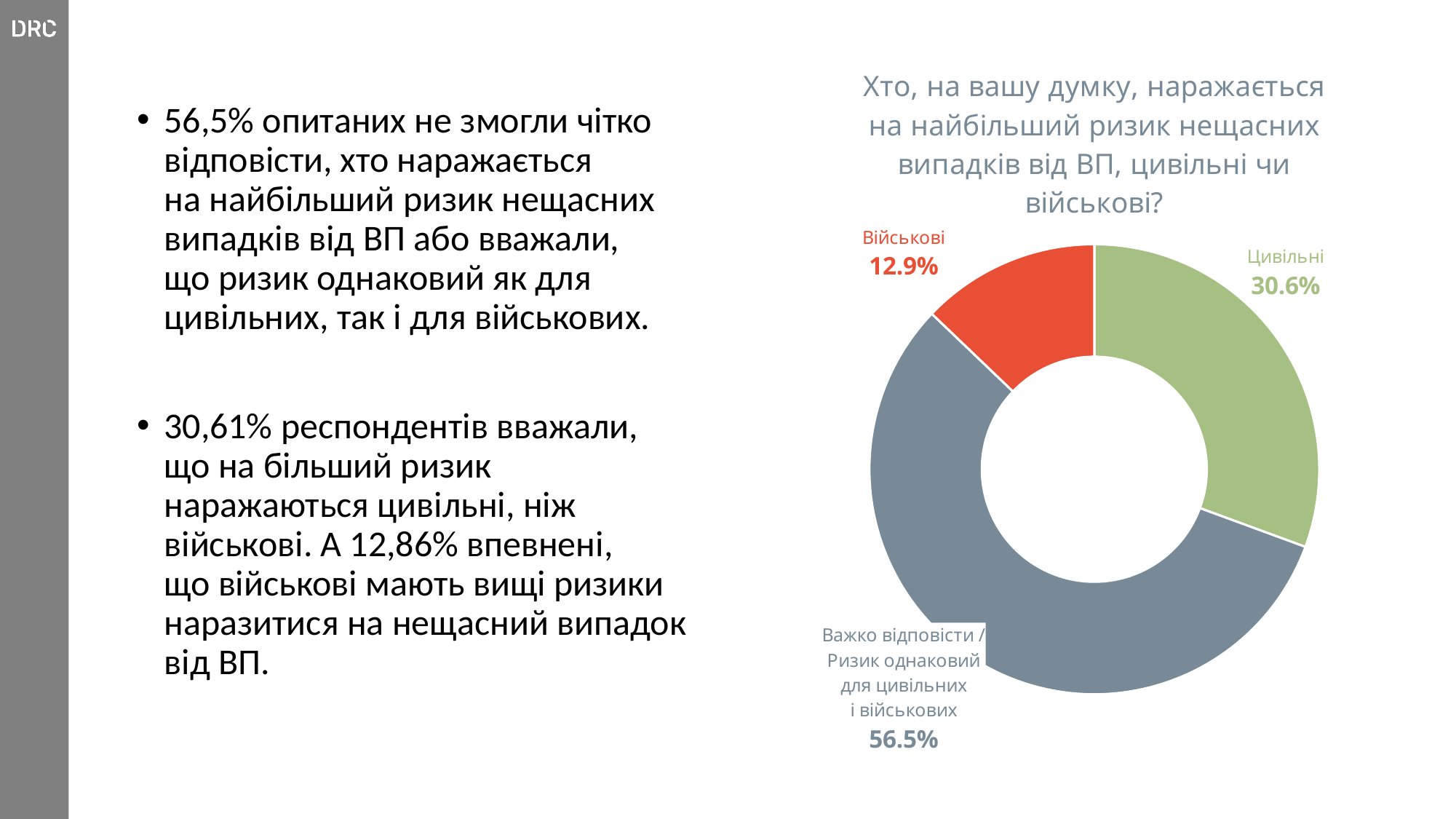
What is the difference in percentage points between the 'Цивільні' and 'Військові' slices? 17.7 How many categories are shown in the chart? 3 What kind of chart is shown on the slide? Pie chart (doughnut) What is the title of the chart? Хто, на вашу думку, наражається на найбільший ризик нещасних випадків від ВП, цивільні чи військові? What colour is the 'Військові' slice? Red What share of the pie does the 'Цивільні' slice represent? 30.6% What share of the pie does the 'Військові' slice represent? 12.9% Which category has the largest slice of the pie? Важко відповісти / Ризик однаковий для цивільних і військових Which slice is larger, 'Цивільні' or 'Військові'? Цивільні What is the difference in percentage points between the largest slice and the 'Цивільні' slice? 25.9 What share of the pie does the 'Важко відповісти / Ризик однаковий для цивільних і військових' slice represent? 56.5% Which category has the smallest slice of the pie? Військові